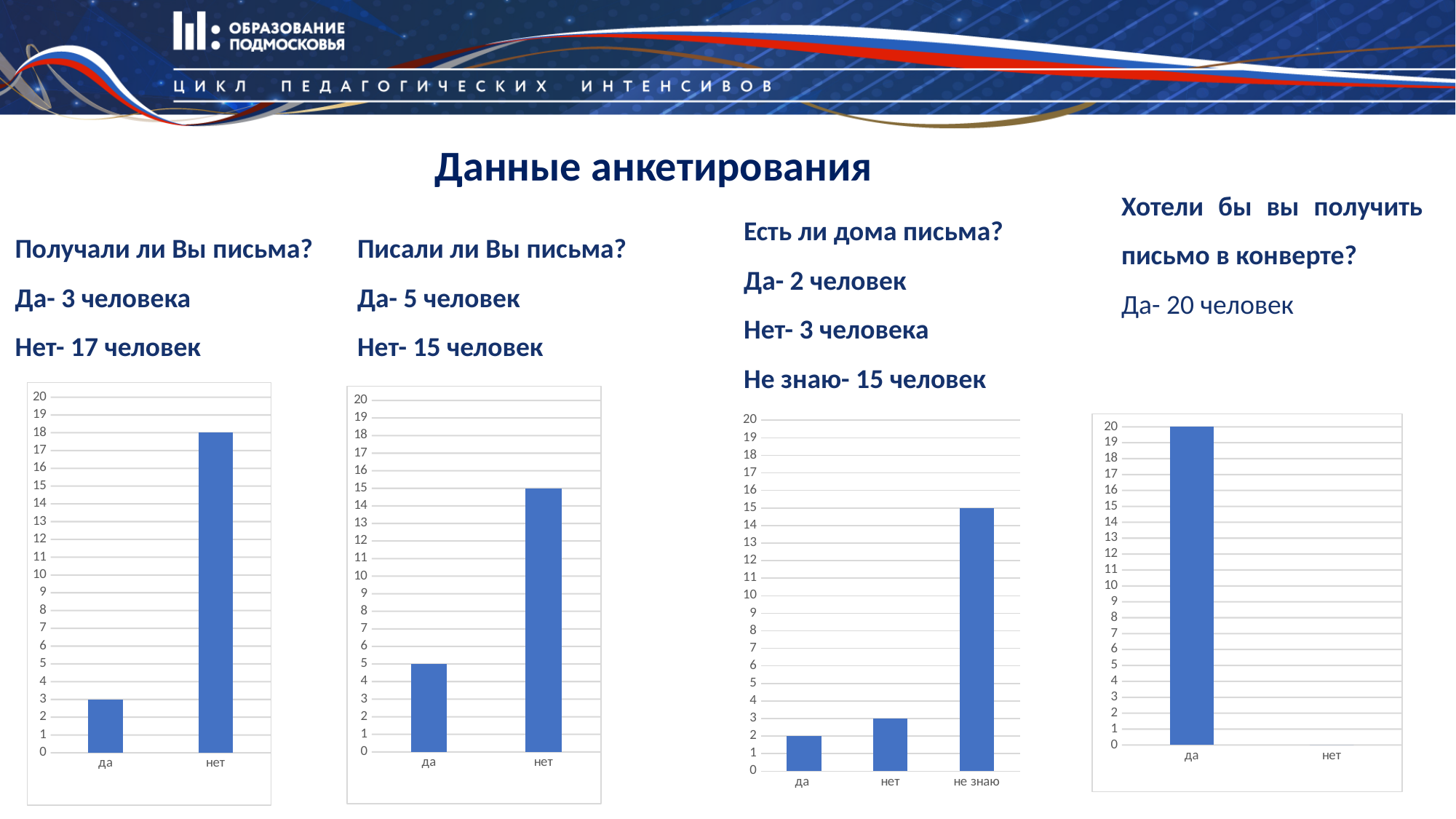
In the leftmost chart ("Получали ли Вы письма?"), is the value for "нет" greater or less than 15? greater In the second chart from the left ("Писали ли Вы письма?"), what is the difference between the values for "нет" and "да"? 10 In the chart under "Есть ли дома письма?" (third from left), which category has the lowest value? да In the chart under "Писали ли Вы письма?" (second from left), what is the value for "да"? 5 How many categories are shown on the x axis of the third chart from the left ("Есть ли дома письма?")? 3 What type of chart is the leftmost chart on the slide? bar chart In the chart under "Есть ли дома письма?" (third from left), which category has the highest value? не знаю In the chart under "Получали ли Вы письма?" (leftmost chart), what is the value for "да"? 3 In the rightmost chart ("Хотели бы вы получить письмо в конверте?"), what is the value for "да"? 20 In the chart under "Писали ли Вы письма?" (second from left), what is the value for "нет"? 15 In the rightmost chart, which is larger, the value for "да" or the value for "нет"? да In the third chart from the left ("Есть ли дома письма?"), what is the value for "нет"? 3